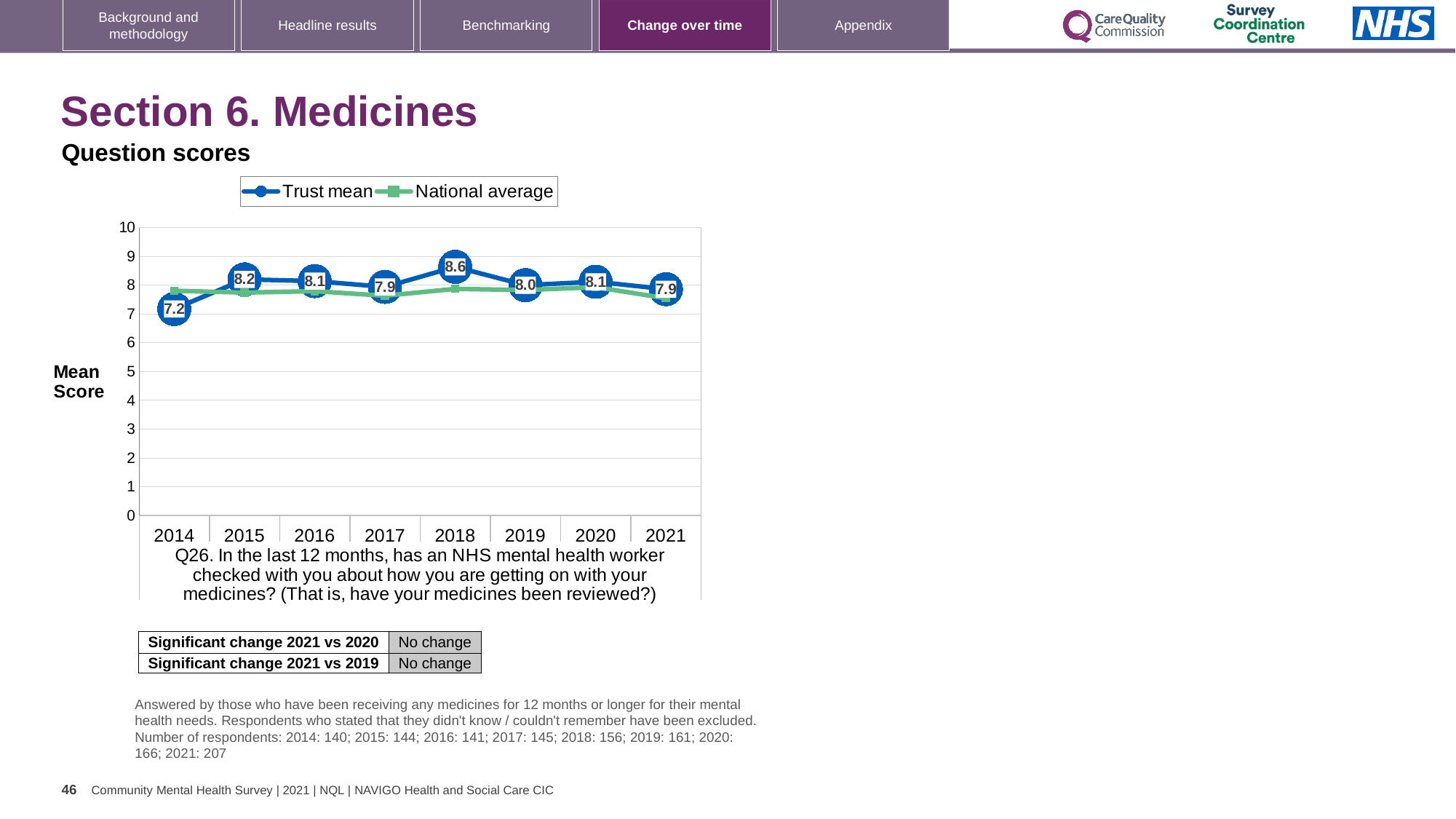
In which year is the Trust mean highest? 2018 What is the Trust mean score for 2018? 8.6 What type of chart is shown on the slide? Line chart What is the difference between the Trust mean in 2018 and in 2014? 1.4 What is the Trust mean score for 2014? 7.2 How many series does the legend list? 2 How many years are plotted on the x axis? 8 Is the National average value for 2014 greater or less than 7? greater In which year is the Trust mean lowest? 2014 What is the label of the y axis? Mean Score Which is larger, the Trust mean in 2015 or in 2019? 2015 What is the Trust mean score for 2021? 7.9